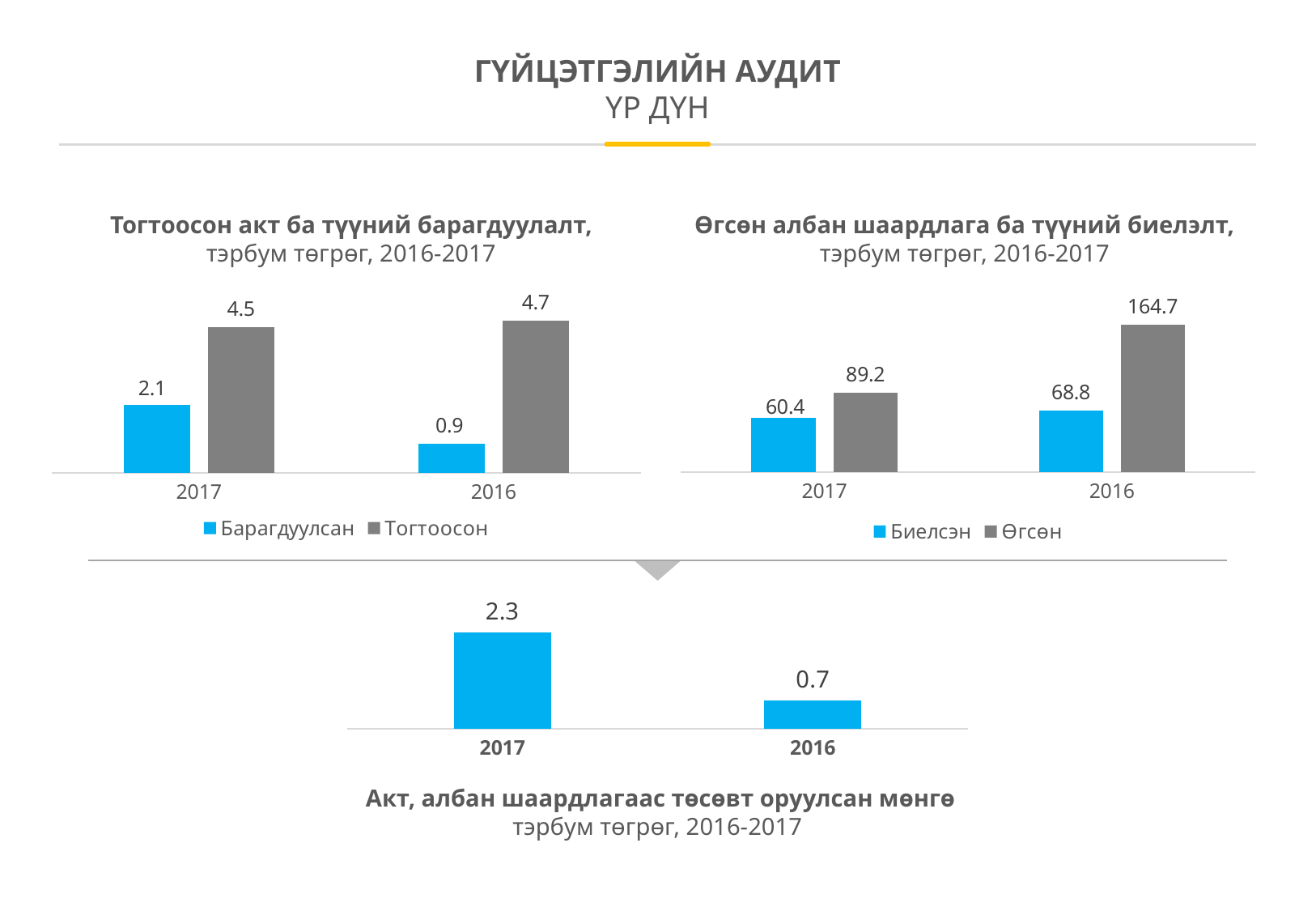
In the top-left chart 'Тогтоосон акт ба түүний барагдуулалт', what is the value of Барагдуулсан for 2017? 2.1 In the top-right chart 'Өгсөн албан шаардлага ба түүний биелэлт', what is the difference between Өгсөн and Биелсэн for 2016? 95.9 In the bottom chart 'Акт, албан шаардлагаас төсөвт оруулсан мөнгө', what is the difference between the 2017 and 2016 values? 1.6 In the top-right chart 'Өгсөн албан шаардлага ба түүний биелэлт', which year has the highest Өгсөн value? 2016 In the top-right chart 'Өгсөн албан шаардлага ба түүний биелэлт', what is the value of Биелсэн for 2017? 60.4 In the bottom chart 'Акт, албан шаардлагаас төсөвт оруулсан мөнгө', what is the value for 2017? 2.3 What kind of chart is the bottom chart 'Акт, албан шаардлагаас төсөвт оруулсан мөнгө'? Bar chart In the bottom chart 'Акт, албан шаардлагаас төсөвт оруулсан мөнгө', which year has the lowest value? 2016 In the top-right chart 'Өгсөн албан шаардлага ба түүний биелэлт', what is the value of Өгсөн for 2016? 164.7 In the top-left chart 'Тогтоосон акт ба түүний барагдуулалт', what is the value of Тогтоосон for 2016? 4.7 In the top-left chart 'Тогтоосон акт ба түүний барагдуулалт', how many series does the legend list? 2 In the top-left chart 'Тогтоосон акт ба түүний барагдуулалт', what is the difference between Тогтоосон and Барагдуулсан for 2017? 2.4